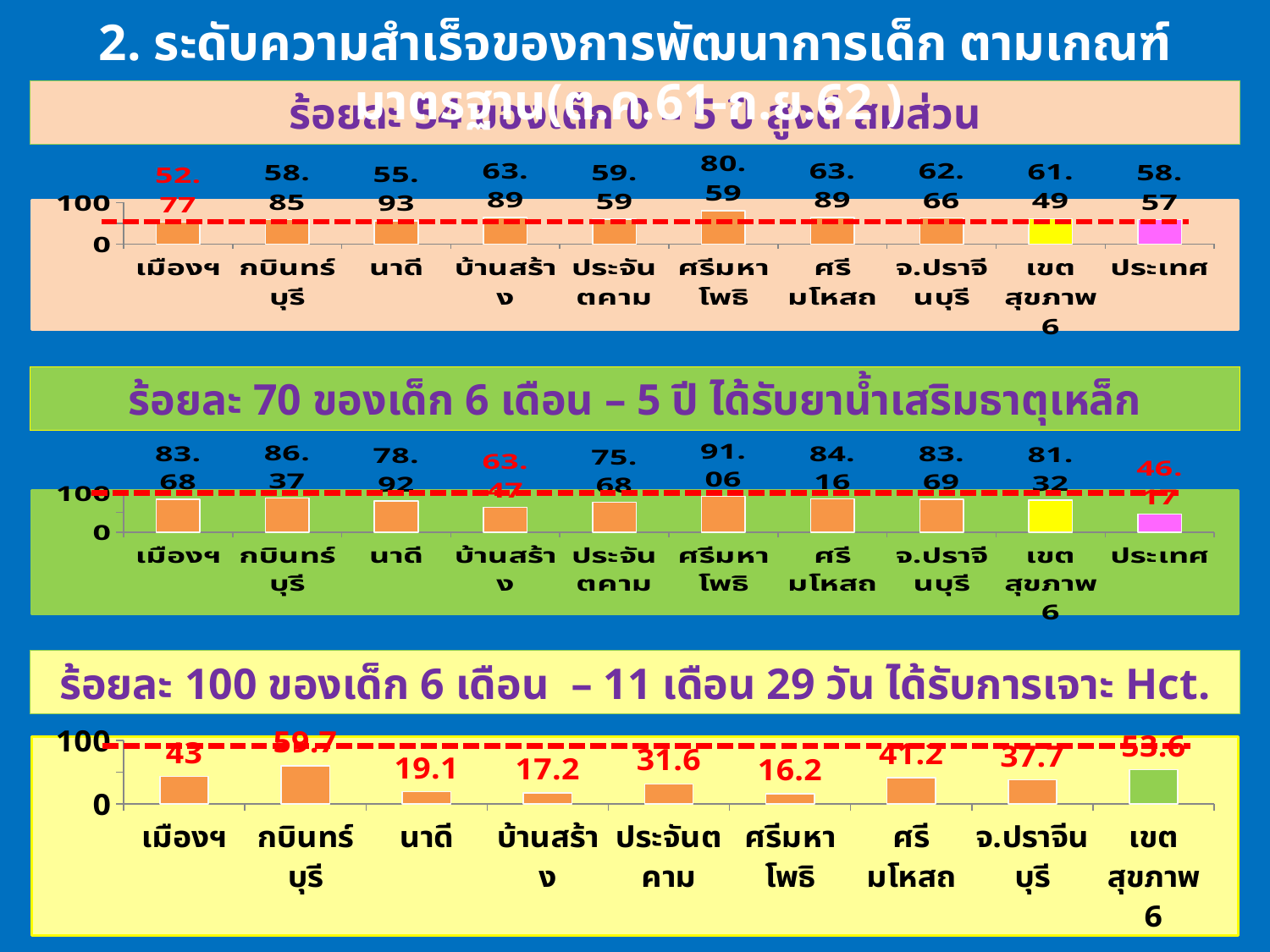
In the top chart, which category has the lowest value? เมืองฯ In the bottom chart, how many categories are shown on the x axis? 9 In the top chart, what is the value for ศรีมหาโพธิ? 80.59 In the middle chart, which is larger, the value for นาดี or the value for ประจันตคาม? นาดี In the top chart, how many categories are shown on the x axis? 10 In the middle chart, what is the difference between the values for กบินทร์บุรี and บ้านสร้าง? 22.90 What type of chart is the bottom chart? Bar chart In the middle chart, what is the value for ประเทศ? 46.17 In the bottom chart, which category has the lowest value? ศรีมหาโพธิ In the top chart, which category has the highest value? ศรีมหาโพธิ In the bottom chart, what is the value for นาดี? 19.1 In the middle chart, which category has the highest value? ศรีมหาโพธิ